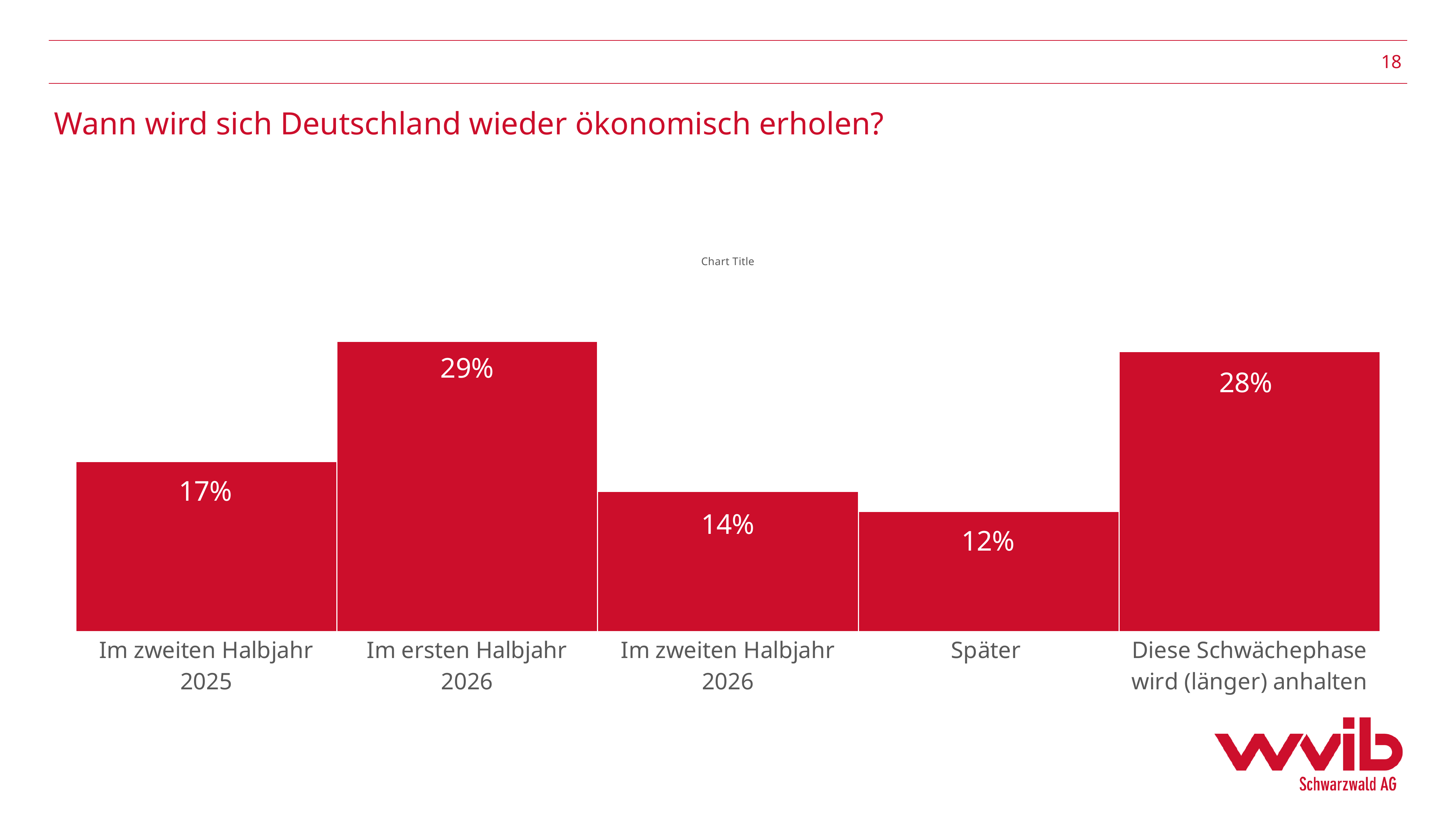
What is the title text shown above the chart? Chart Title Which category has the lowest value? Später What is the difference between the values for "Im zweiten Halbjahr 2025" and "Später"? 5% What is the value for "Diese Schwächephase wird (länger) anhalten"? 28% What kind of chart is shown on the slide? Bar chart What is the difference between the values for "Im ersten Halbjahr 2026" and "Im zweiten Halbjahr 2026"? 15% What is the value for "Im ersten Halbjahr 2026"? 29% Which category has the highest value? Im ersten Halbjahr 2026 What is the value for "Später"? 12% Which is larger, the value for "Im zweiten Halbjahr 2025" or the value for "Im zweiten Halbjahr 2026"? Im zweiten Halbjahr 2025 How many categories are shown in the chart? 5 What is the value for "Im zweiten Halbjahr 2025"? 17%